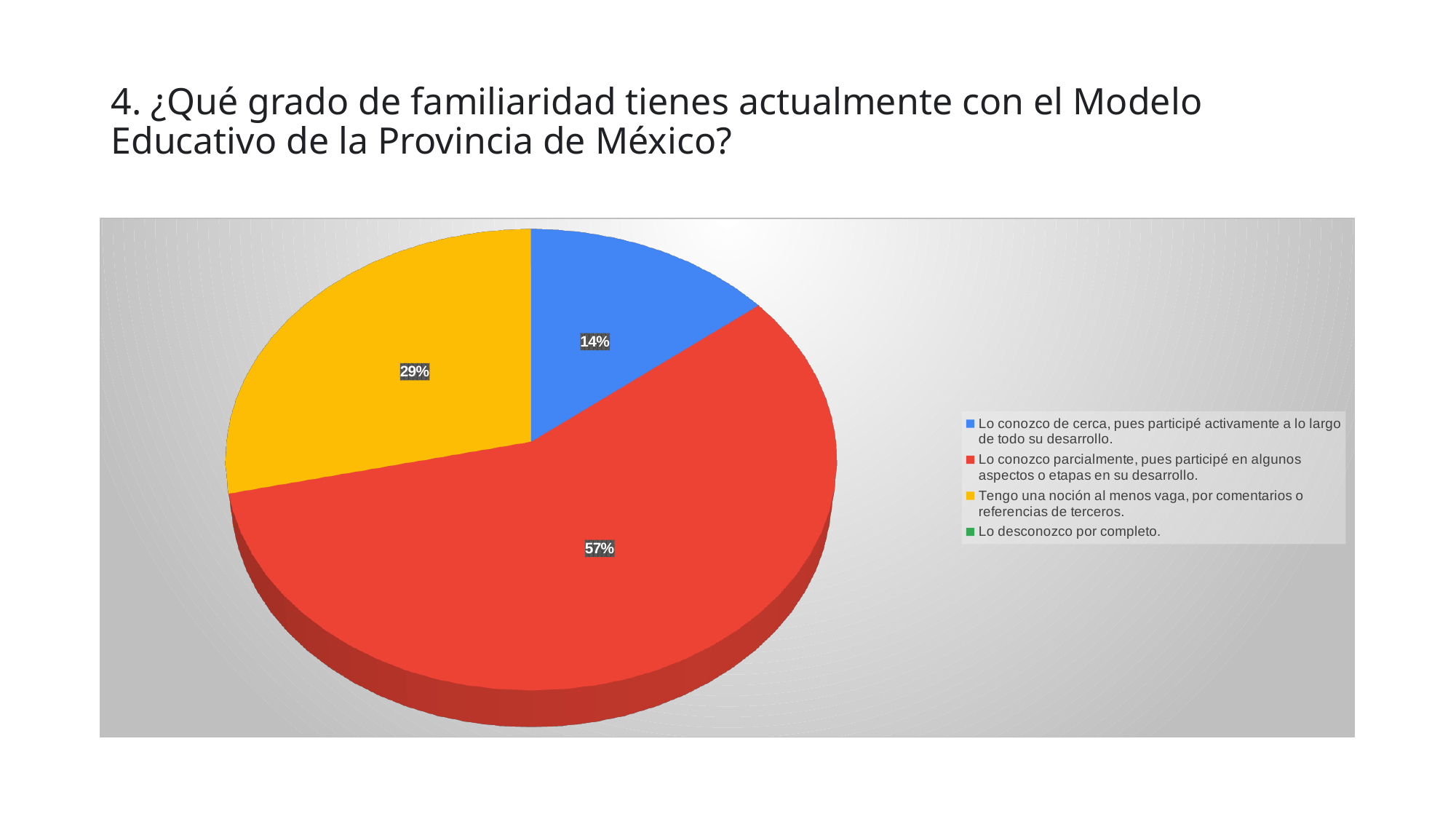
What share of the pie corresponds to "Lo conozco parcialmente, pues participé en algunos aspectos o etapas en su desarrollo."? 57% What kind of chart is shown on the slide? pie chart What colour is the slice labelled 29%? yellow What share of the pie corresponds to "Tengo una noción al menos vaga, por comentarios o referencias de terceros."? 29% What is the difference in percentage points between the red slice (57%) and the yellow slice (29%)? 28 Which category has the largest slice of the pie? Lo conozco parcialmente, pues participé en algunos aspectos o etapas en su desarrollo. How many entries does the legend list? 4 Which is larger: the share for "Tengo una noción al menos vaga..." or the share for "Lo conozco de cerca..."? Tengo una noción al menos vaga, por comentarios o referencias de terceros. Which legend entry has no visible slice in the pie? Lo desconozco por completo. Which of the visible slices is the smallest? Lo conozco de cerca, pues participé activamente a lo largo de todo su desarrollo. How many slices with a percentage label are visible in the pie? 3 What share of the pie corresponds to "Lo conozco de cerca, pues participé activamente a lo largo de todo su desarrollo."? 14%